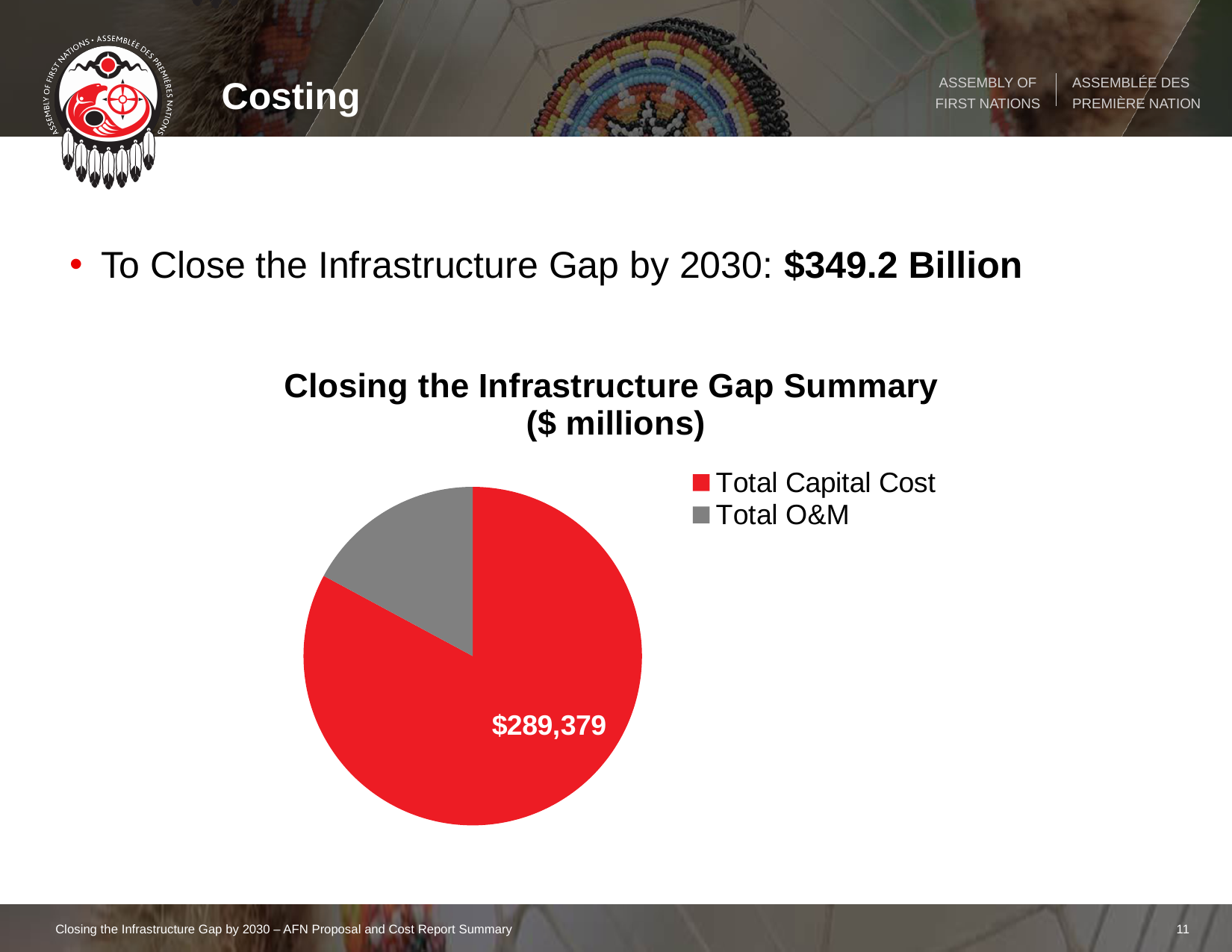
How many entries does the chart legend list? 2 What is the value shown for Total Capital Cost in the pie chart? $289,379 What is the title of the chart? Closing the Infrastructure Gap Summary ($ millions) How many slices does the pie chart have? 2 Is the Total Capital Cost slice more or less than half of the pie? More Which slice of the pie chart is the largest? Total Capital Cost What colour represents Total O&M in the pie chart? Grey Which is larger in the pie chart, Total Capital Cost or Total O&M? Total Capital Cost Which slice of the pie chart is the smallest? Total O&M What kind of chart is shown on the slide? Pie chart